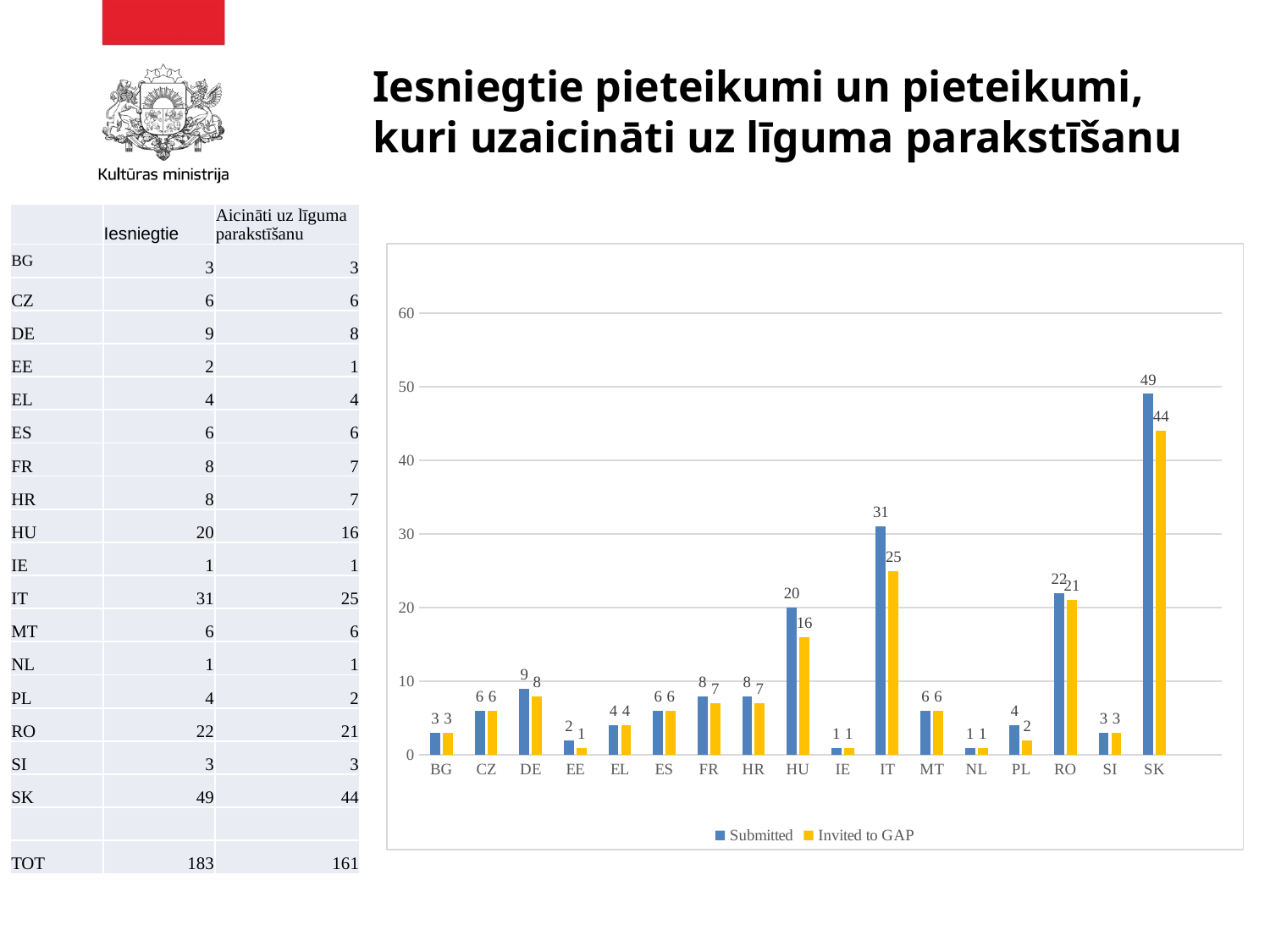
What is the Submitted value for HU? 20 Which is larger, the Submitted value for IT or the Submitted value for RO? IT How many countries are shown on the x axis of the chart? 17 What kind of chart is shown on the slide? bar chart What is the Invited to GAP value for IT? 25 What is the difference between the Submitted and Invited to GAP values for SK? 5 Which country has the highest Submitted value? SK How many series does the chart legend list? 2 What is the Invited to GAP value for EE? 1 What colour are the Invited to GAP bars in the chart? yellow What is the difference between the Submitted and Invited to GAP values for HU? 4 Is the Submitted value for SK greater or less than 40? greater